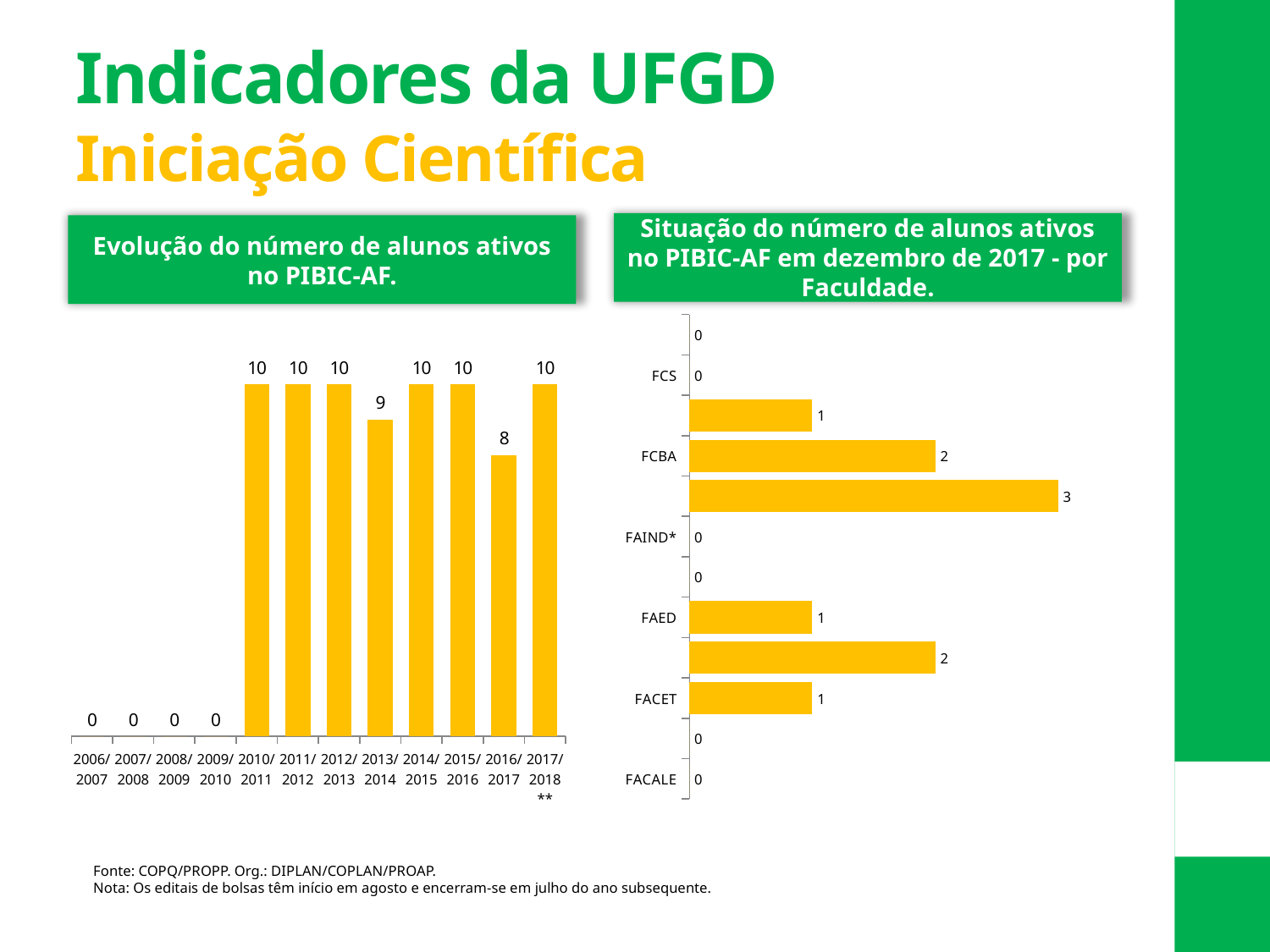
In the chart 'Evolução do número de alunos ativos no PIBIC-AF', what is the value for 2016/2017? 8 In the chart 'Evolução do número de alunos ativos no PIBIC-AF', which is larger, the value for 2013/2014 or the value for 2016/2017? 2013/2014 In the chart 'Evolução do número de alunos ativos no PIBIC-AF', what is the difference between the values for 2015/2016 and 2016/2017? 2 In the chart 'Evolução do número de alunos ativos no PIBIC-AF', do the values rise or fall from 2009/2010 to 2010/2011? Rise In the chart 'Situação do número de alunos ativos no PIBIC-AF em dezembro de 2017 - por Faculdade', what is the largest value labeled on any bar? 3 In the chart 'Situação do número de alunos ativos no PIBIC-AF em dezembro de 2017 - por Faculdade', what is the value for FACALE? 0 In the chart 'Situação do número de alunos ativos no PIBIC-AF em dezembro de 2017 - por Faculdade', what is the value for FAED? 1 In the chart 'Evolução do número de alunos ativos no PIBIC-AF', what is the value for 2008/2009? 0 What kind of chart is 'Evolução do número de alunos ativos no PIBIC-AF'? Bar chart In the chart 'Evolução do número de alunos ativos no PIBIC-AF', how many year periods are shown on the x axis? 12 In the chart 'Situação do número de alunos ativos no PIBIC-AF em dezembro de 2017 - por Faculdade', what is the value for FCBA? 2 In the chart 'Evolução do número de alunos ativos no PIBIC-AF', what is the value for 2013/2014? 9